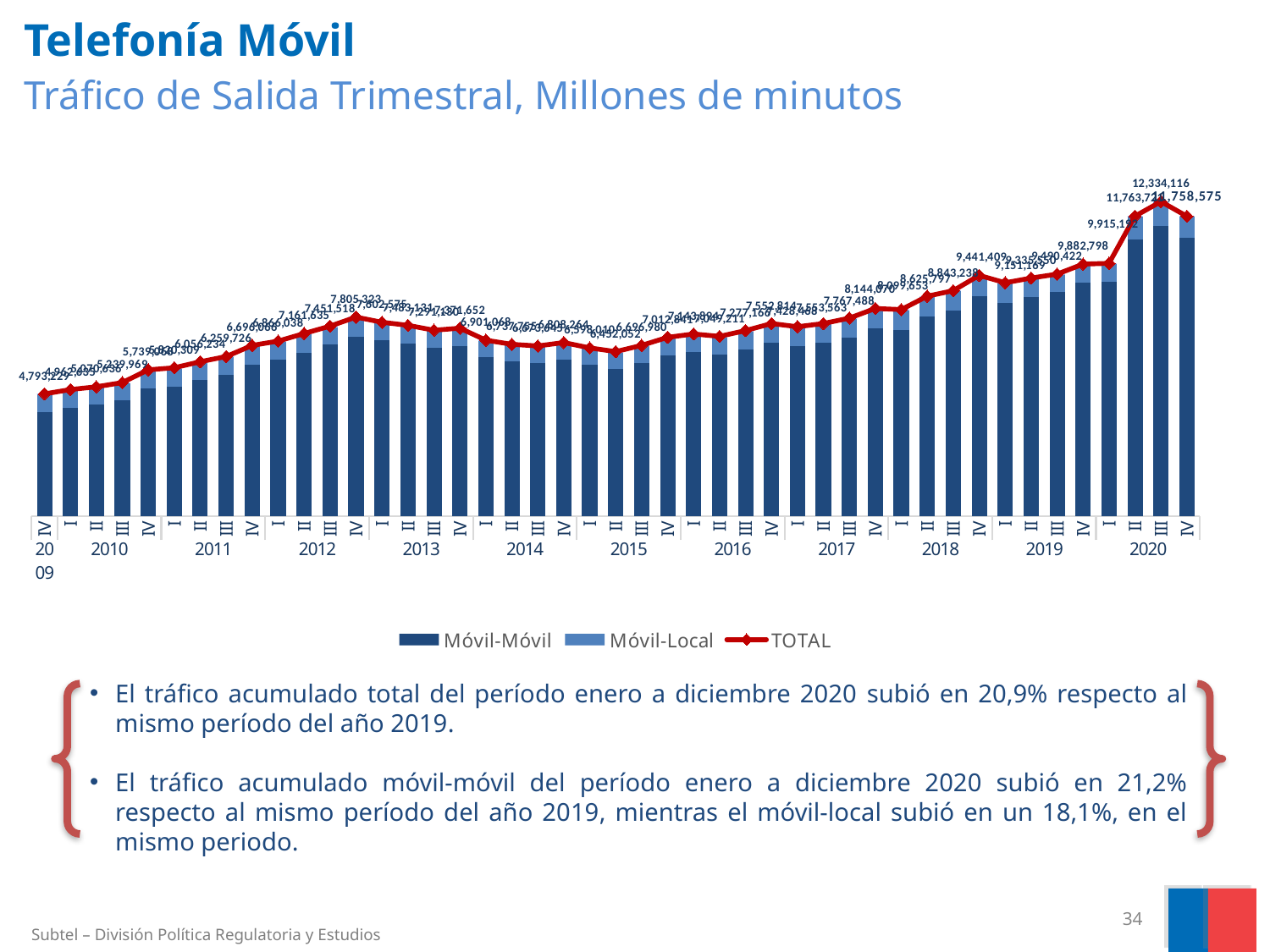
What is the difference between the TOTAL values for quarter III of 2020 and quarter IV of 2020? 575,541 What is the TOTAL value for quarter IV of 2020? 11,758,575 How many series does the legend list? 3 Which is larger, the TOTAL for quarter IV of 2019 or the TOTAL for quarter IV of 2018? IV 2019 Which series is shown as a red line with diamond markers? TOTAL What is the TOTAL value for quarter IV of 2019? 9,882,798 In which quarter does the TOTAL line have its lowest value? IV 2009 In which quarter does the TOTAL line reach its highest value? III 2020 What is the TOTAL value for quarter IV of 2018? 9,441,409 What is the TOTAL value for quarter III of 2020? 12,334,116 What kind of chart is shown on the slide? Stacked bar chart combined with a line chart What is the TOTAL value for quarter IV of 2012? 7,805,323